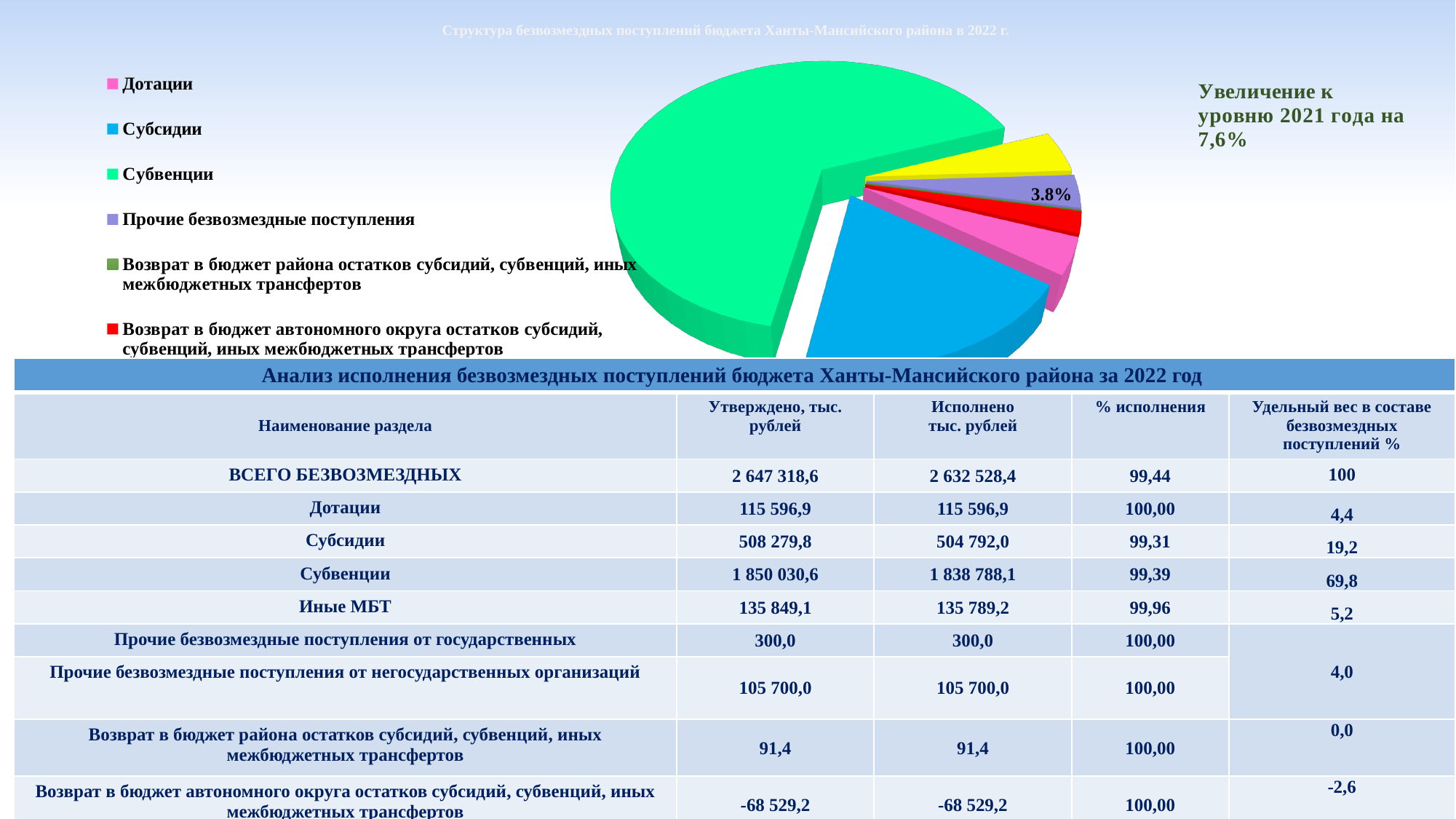
In the pie chart, which slice is larger: Субвенции or Субсидии? Субвенции What colour is the Субсидии slice in the pie chart? blue What kind of chart is shown on the slide? pie chart What percentage is printed on the purple slice (Прочие безвозмездные поступления) of the pie chart? 3.8% What colour is the Субвенции slice in the pie chart? green How many entries does the legend of the pie chart list? 6 In the pie chart, which slice is larger: Субсидии or Дотации? Субсидии Which category has the largest slice in the pie chart? Субвенции